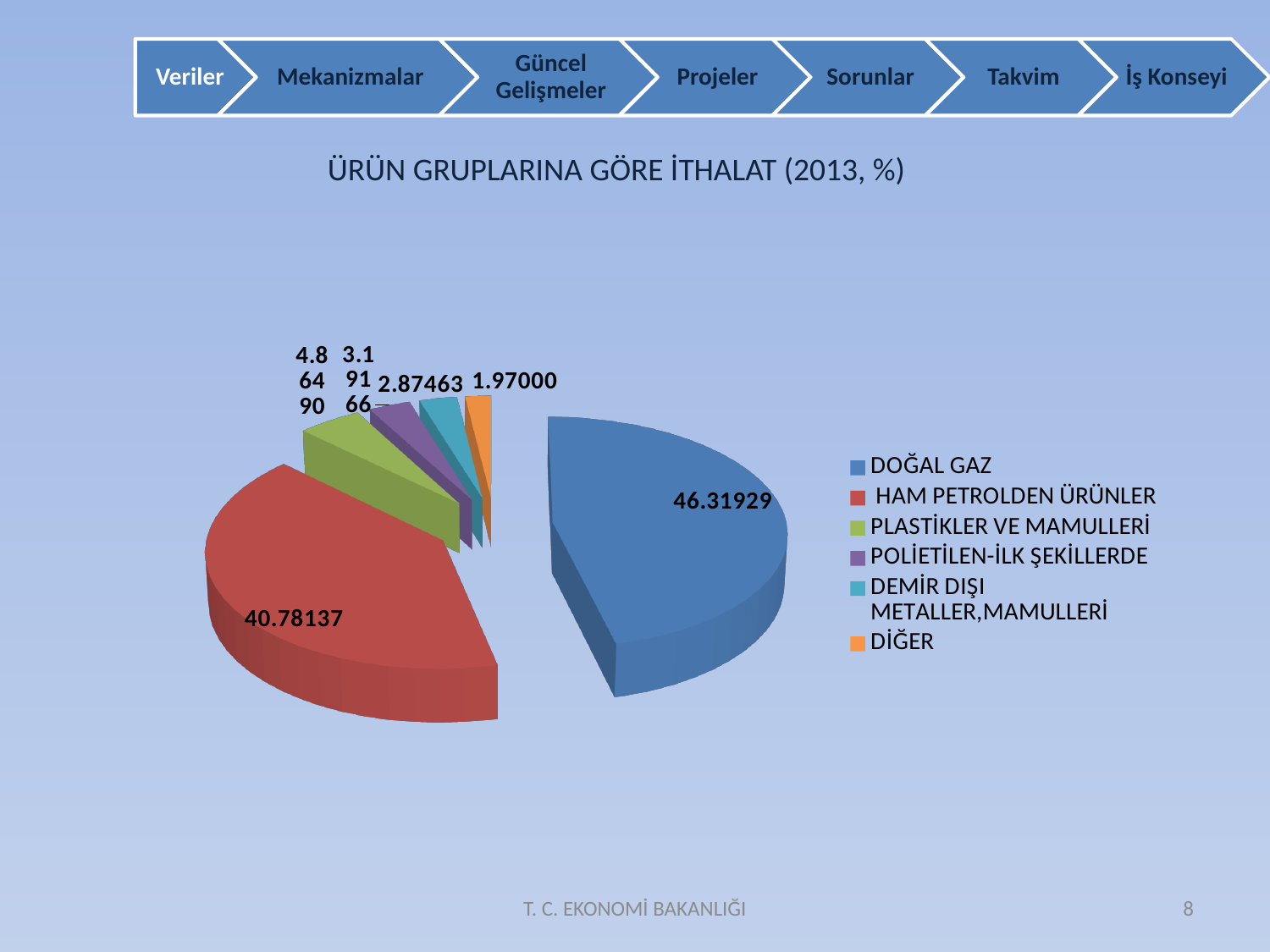
Which product group has the largest share of the pie? DOĞAL GAZ What is the value shown for DEMİR DIŞI METALLER,MAMULLERİ? 2.87463 Which is larger, the slice for PLASTİKLER VE MAMULLERİ or the slice for POLİETİLEN-İLK ŞEKİLLERDE? PLASTİKLER VE MAMULLERİ What is the difference between the values for DOĞAL GAZ and HAM PETROLDEN ÜRÜNLER? 5.53792 What is the difference between the values for DEMİR DIŞI METALLER,MAMULLERİ and DİĞER? 0.90463 How many product groups are listed in the legend of the pie chart? 6 What is the title of the chart? ÜRÜN GRUPLARINA GÖRE İTHALAT (2013, %) What kind of chart is shown on the slide? pie chart What is the value shown for DİĞER? 1.97000 What is the value shown for DOĞAL GAZ? 46.31929 Which product group has the smallest share of the pie? DİĞER What is the value shown for HAM PETROLDEN ÜRÜNLER? 40.78137